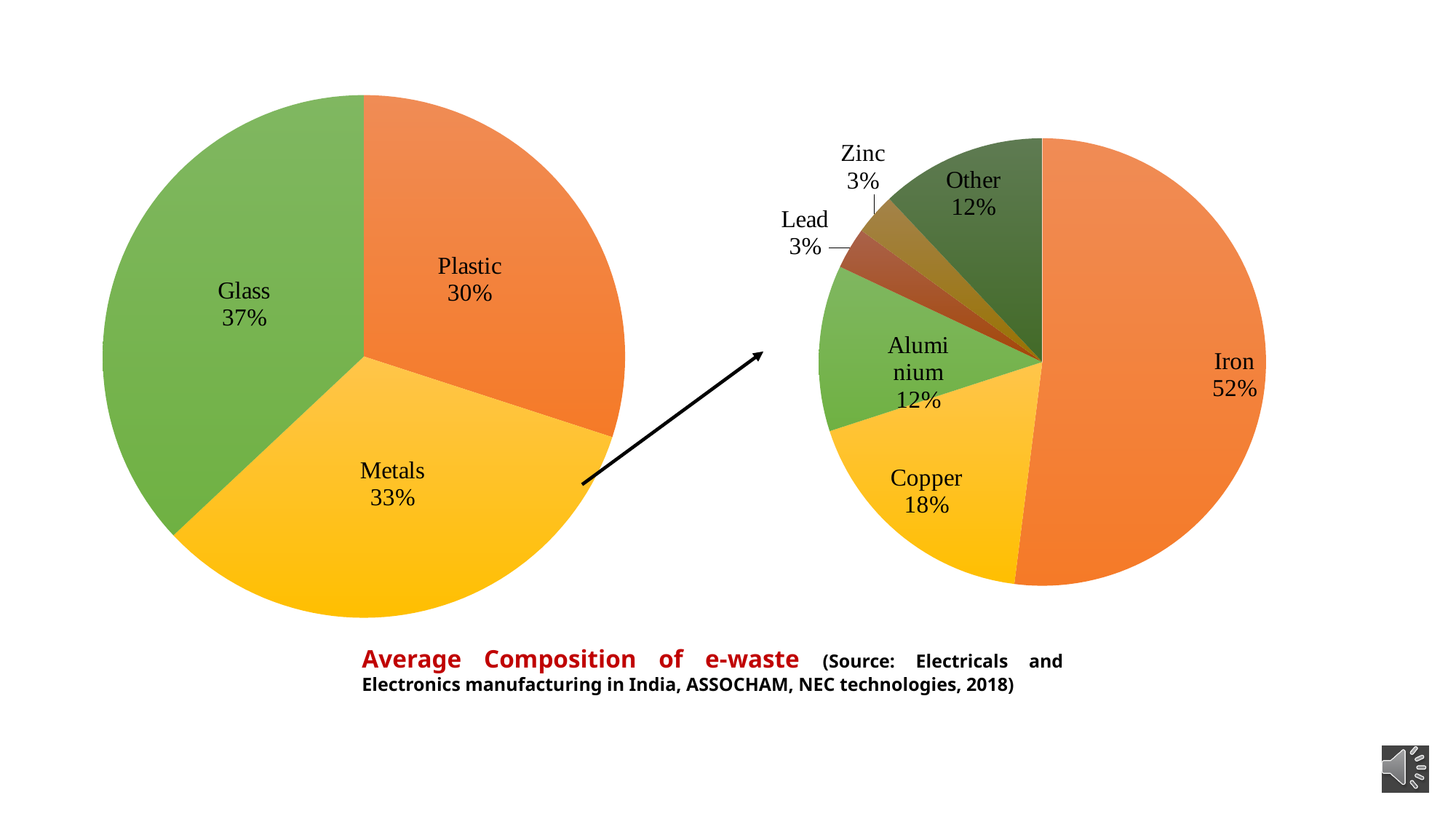
In the left pie chart, what share of e-waste is Plastic? 30% How many slices does the right pie chart have? 6 How many slices does the left pie chart have? 3 In the right pie chart, what share is Copper? 18% In the left pie chart, what share of e-waste is Glass? 37% What type of chart is used on this slide? Pie chart In the left pie chart, which category has the largest share? Glass In the left pie chart, which category has the smallest share? Plastic In the right pie chart, which is larger, Copper or Aluminium? Copper In the right pie chart, which metal has the largest share? Iron In the left pie chart, what is the difference between the Glass and Metals shares? 4% In the right pie chart, what share is Iron? 52%